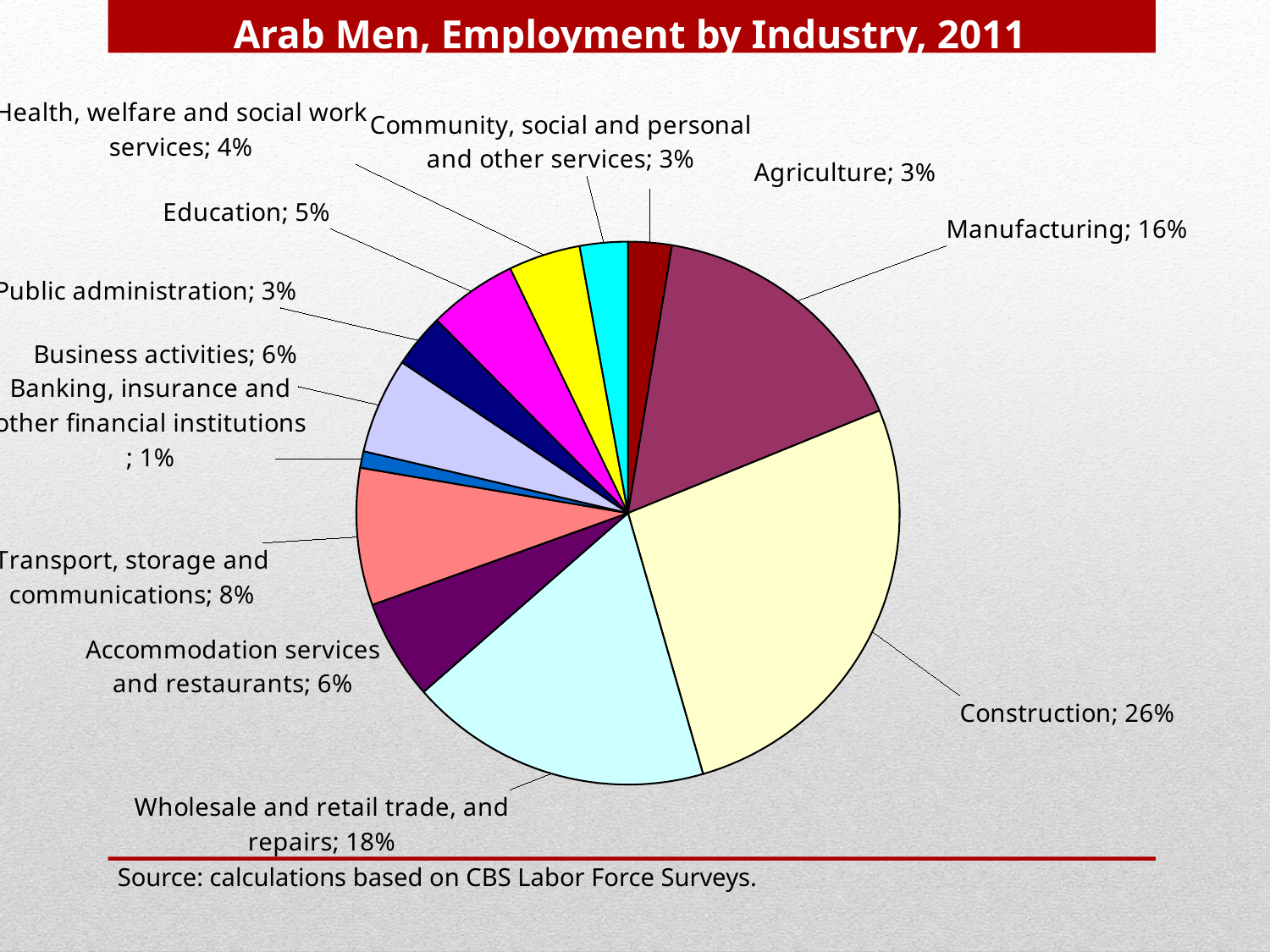
What share of employment is in Manufacturing? 16% Which has a larger share, Education or Business activities? Business activities Which industry has the smallest share of employment? Banking, insurance and other financial institutions What share of employment is in Wholesale and retail trade, and repairs? 18% What share of employment is in Construction? 26% What is the difference between the Construction share and the Manufacturing share? 10% What kind of chart is shown on the slide? Pie chart How many industry slices does the pie chart have? 12 What is the title of the chart? Arab Men, Employment by Industry, 2011 What is the combined share of Construction and Wholesale and retail trade, and repairs? 44% What share of employment is in Transport, storage and communications? 8% Which industry has the largest share of employment? Construction